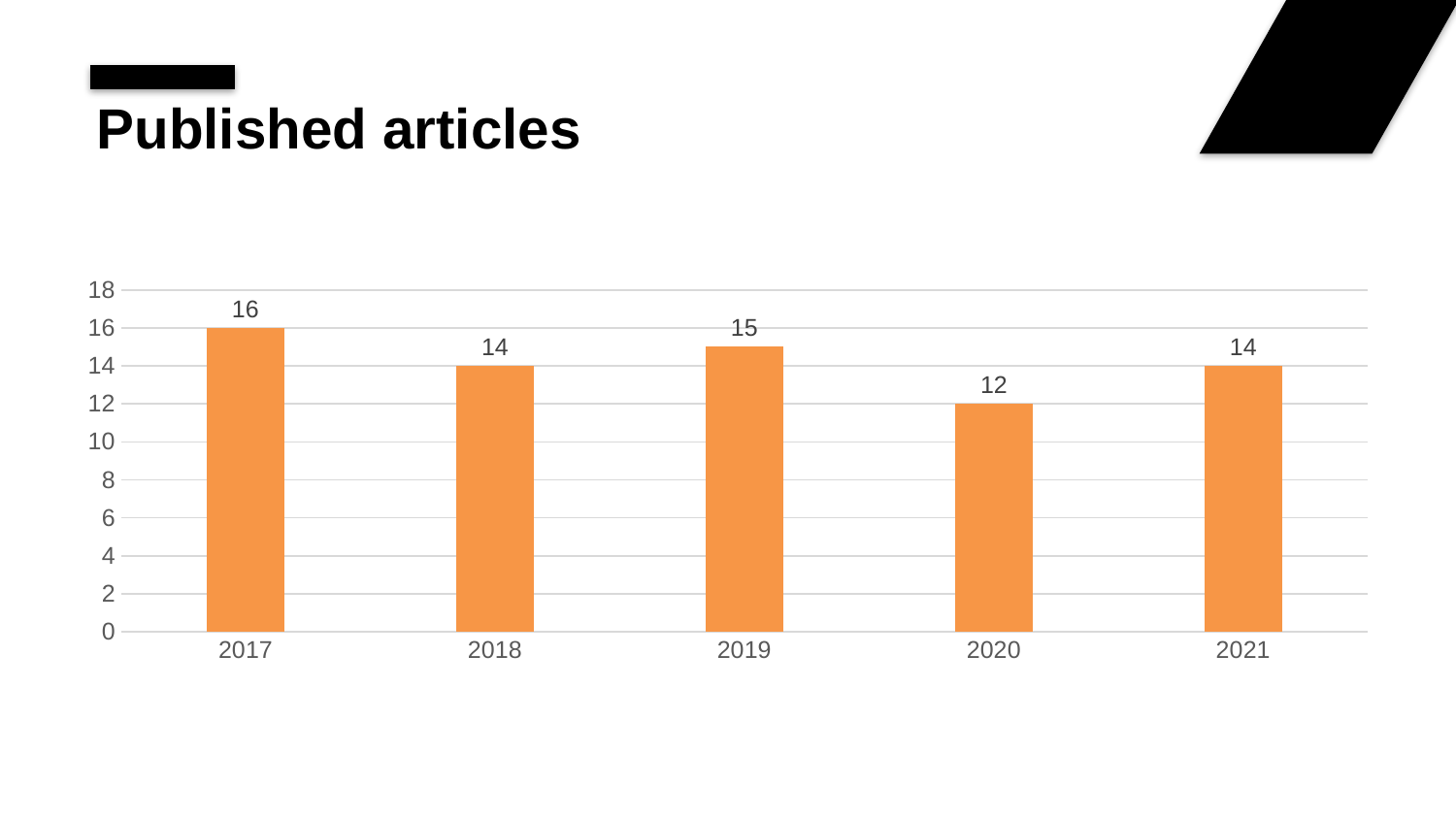
How many published articles were there in 2017? 16 What is the value shown for 2020? 12 What is the difference between the values for 2017 and 2020? 4 Which year has the highest number of published articles? 2017 What kind of chart is shown on the slide? bar chart Which year has the lowest number of published articles? 2020 How many years are shown on the x axis? 5 What is the difference between the values for 2019 and 2018? 1 Is the value for 2020 greater or less than 14? less Which is larger, the value for 2019 or the value for 2021? 2019 What is the value shown for 2019? 15 What is the title of the slide containing the chart? Published articles